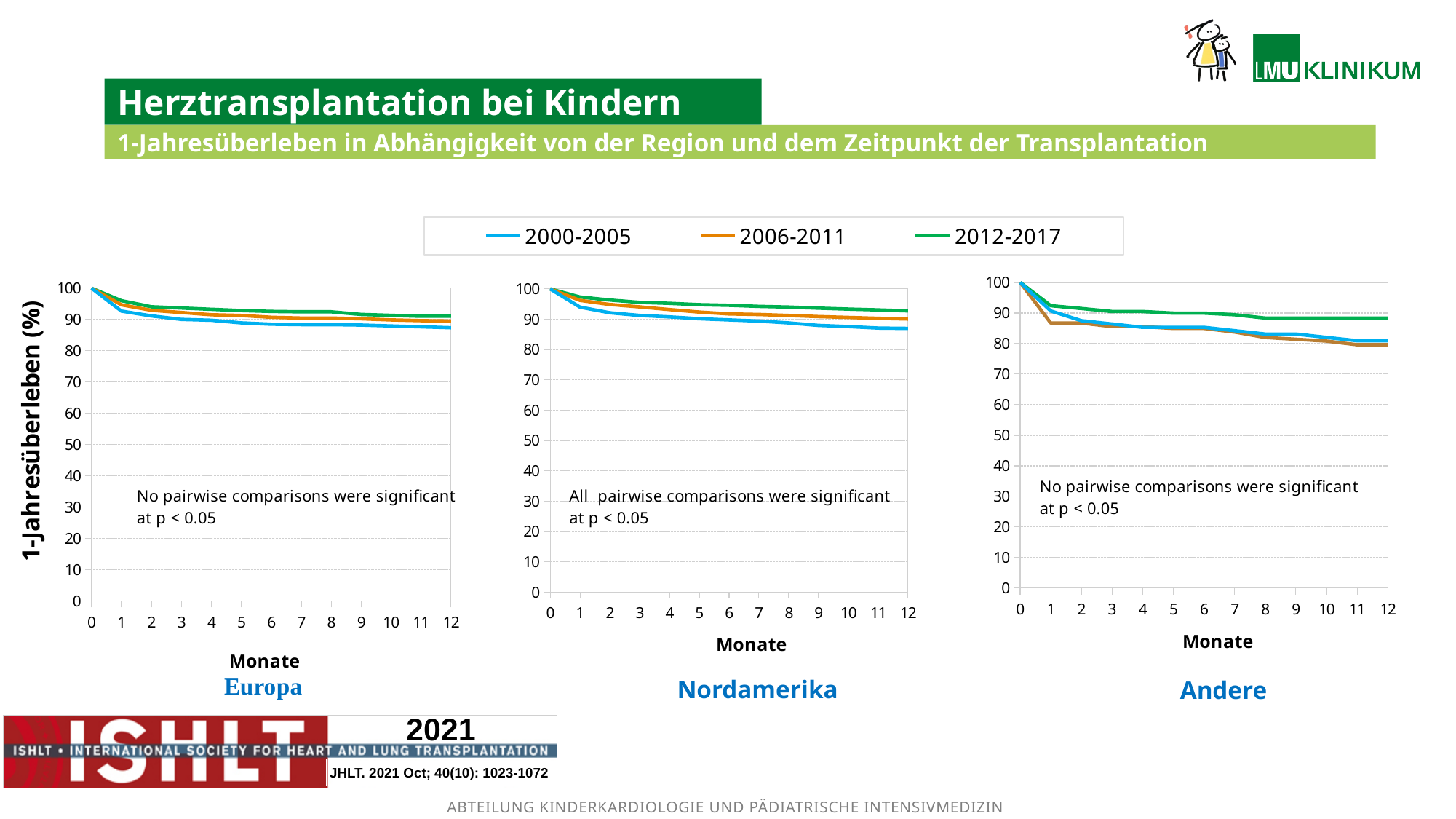
In the Nordamerika chart, which series has the higher value at month 12, 2000-2005 or 2012-2017? 2012-2017 How many series does the legend list? 3 In the Andere chart, which series has the higher value at month 12, 2006-2011 or 2012-2017? 2012-2017 In the Nordamerika chart, what is the value of the 2000-2005 series at month 0? 100 In the Andere chart, how many month ticks are shown on the x axis from 0 to 12? 13 In the Europa chart, is the value for 2000-2005 at month 12 greater or less than 90? less What is the label of the y axis shared by the three charts? 1-Jahresüberleben (%) In the Nordamerika chart, is the value for 2012-2017 at month 12 greater or less than 90? greater In the Andere chart, is the value for 2012-2017 at month 12 greater or less than 80? greater In the Europa chart, do the values of the 2000-2005 series rise or fall from month 0 to month 12? fall What kind of chart is the Europa chart? line chart In the Europa chart, what is the value of the 2012-2017 series at month 0? 100